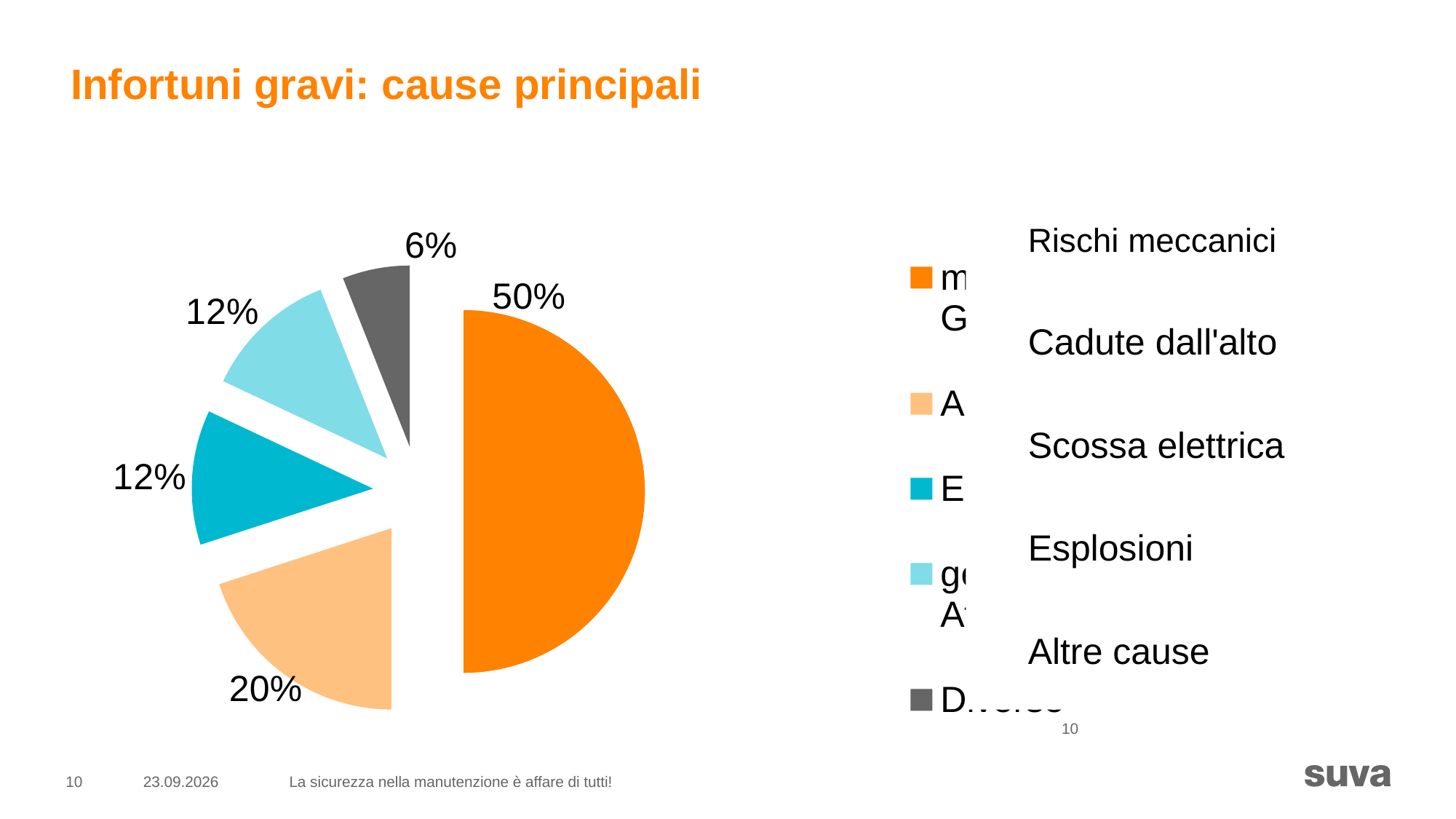
What kind of chart is shown on the slide? pie chart Which slice is larger, the orange slice or the light orange slice? the orange slice What is the value of the largest slice in the pie chart? 50% What percentage is shown for the orange slice of the pie chart? 50% What is the value of the smallest slice in the pie chart? 6% What do the two 12% slices add up to together? 24% What share of the pie is labelled 'Rischi meccanici'? 50% What is the difference in percentage points between the orange slice (50%) and the light orange slice (20%)? 30 What is the title of the slide containing the pie chart? Infortuni gravi: cause principali What percentage is shown for the grey slice of the pie chart? 6% How many slices does the pie chart have? 5 What percentage is shown for the light orange (peach) slice of the pie chart? 20%